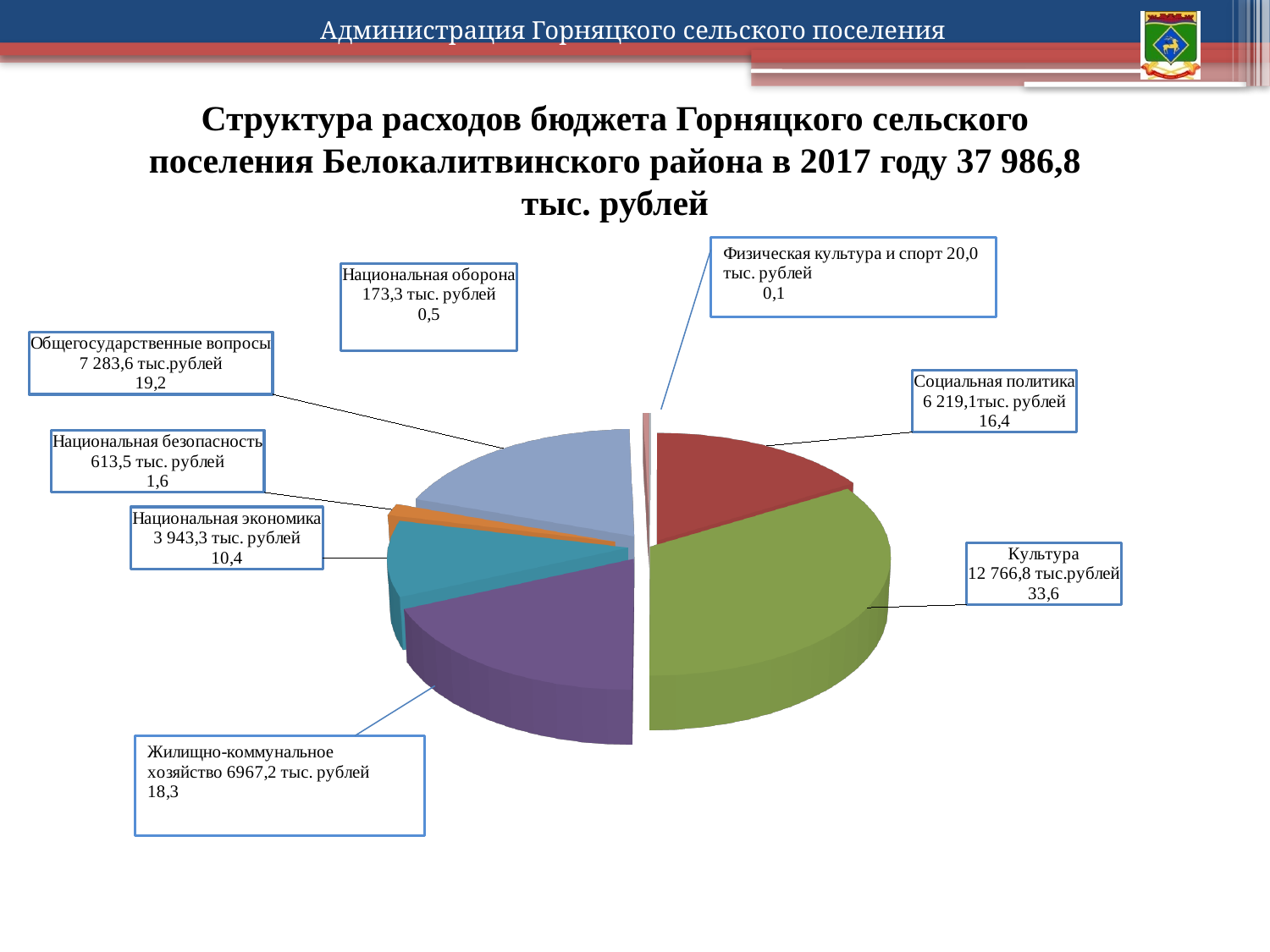
What is the amount shown for Общегосударственные вопросы? 7 283,6 тыс.рублей What is the amount shown for Национальная экономика? 3 943,3 тыс. рублей What is the amount shown for Культура? 12 766,8 тыс.рублей How many expenditure categories are labelled on the pie chart? 8 What total budget expenditure is stated in the chart title? 37 986,8 тыс. рублей What is the difference in share between Общегосударственные вопросы and Жилищно-коммунальное хозяйство? 0,9 Which category has the smallest share of expenditure? Физическая культура и спорт Which category has the largest share of expenditure? Культура What share of the budget expenditure does Культура account for? 33,6 What share is shown for Социальная политика? 16,4 What kind of chart is shown on the slide? pie chart Which is larger, the amount for Жилищно-коммунальное хозяйство or for Социальная политика? Жилищно-коммунальное хозяйство